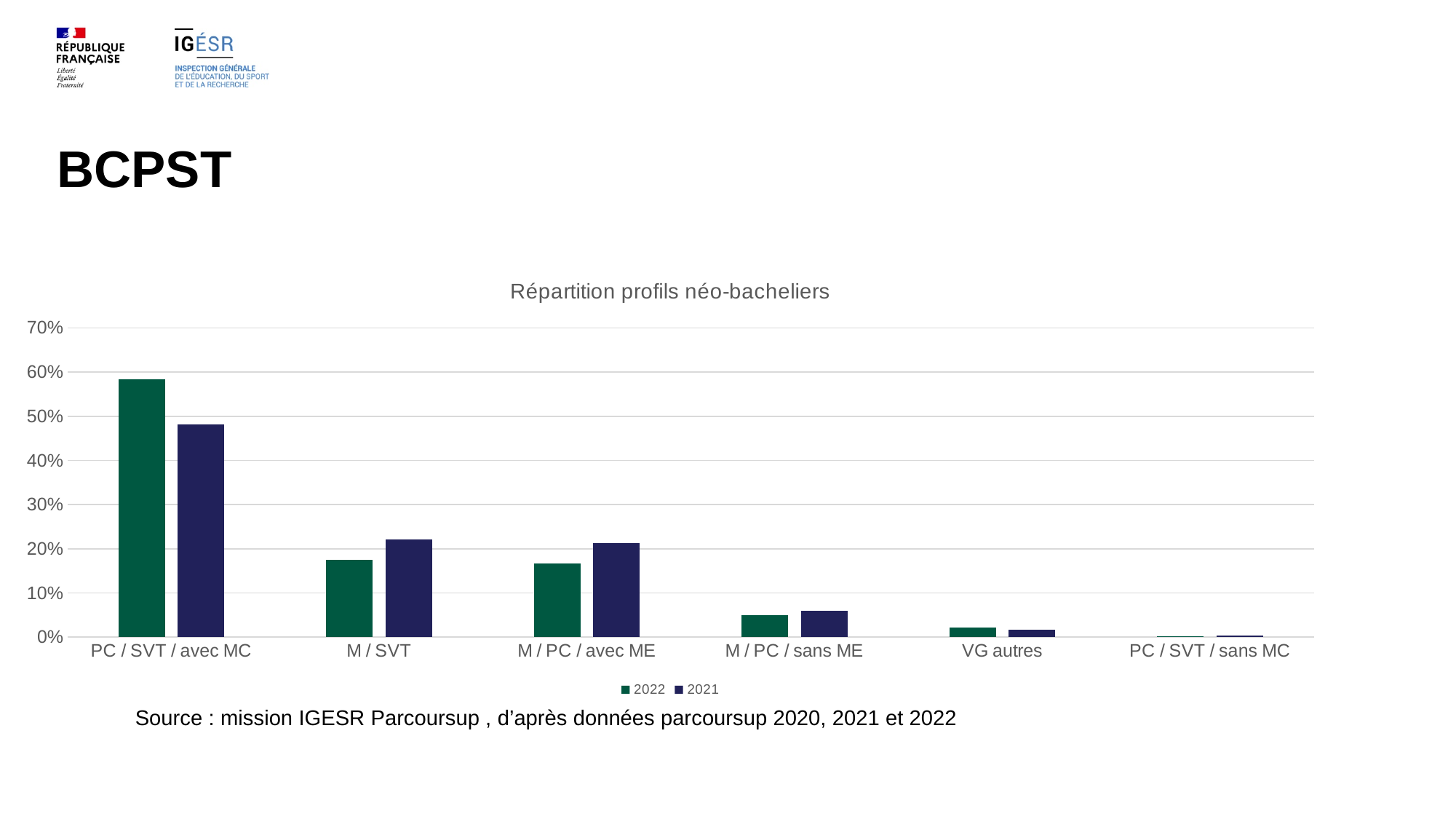
How many categories are shown on the x axis? 6 Which category has the highest value for the 2022 series? PC / SVT / avec MC What is the title of the chart? Répartition profils néo-bacheliers Is the 2022 value for M / PC / sans ME greater or less than 10%? less Is the 2021 value for M / SVT greater or less than 20%? greater Is the 2021 value for PC / SVT / avec MC greater or less than 50%? less What type of chart is shown on the slide? Bar chart For M / SVT, which series has the larger value, 2022 or 2021? 2021 How many series does the legend list? 2 For PC / SVT / avec MC, which series has the larger value, 2022 or 2021? 2022 Which category has the lowest value for the 2021 series? PC / SVT / sans MC